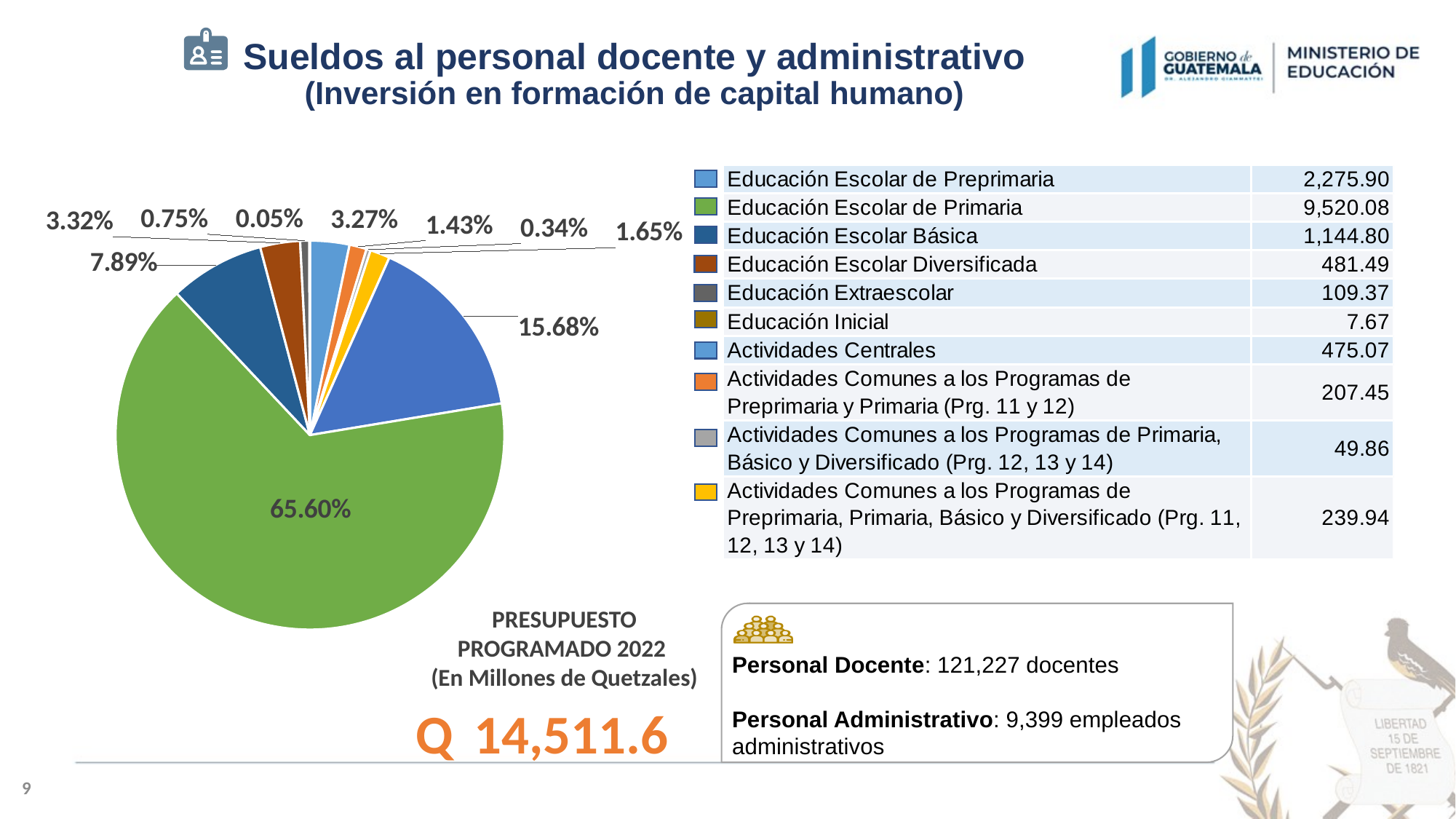
Which category has the largest share of the pie? Educación Escolar de Primaria What is the difference between the values for Educación Escolar de Preprimaria and Educación Escolar Básica? 1,131.10 How many categories does the legend of the pie chart list? 10 What type of chart is shown on the slide? Pie chart What is the value shown for Actividades Centrales? 475.07 What is the value shown for Educación Escolar Básica? 1,144.80 What percentage share of the pie does Educación Escolar Básica have? 7.89% Which category has the smallest value in the table? Educación Inicial What is the total programmed budget for 2022 shown on the slide, in millions of quetzales? Q 14,511.6 Which is larger, the value for Educación Escolar Diversificada or the value for Actividades Centrales? Educación Escolar Diversificada What percentage share of the pie does Educación Escolar de Primaria have? 65.60% What is the value shown for Educación Escolar de Primaria? 9,520.08